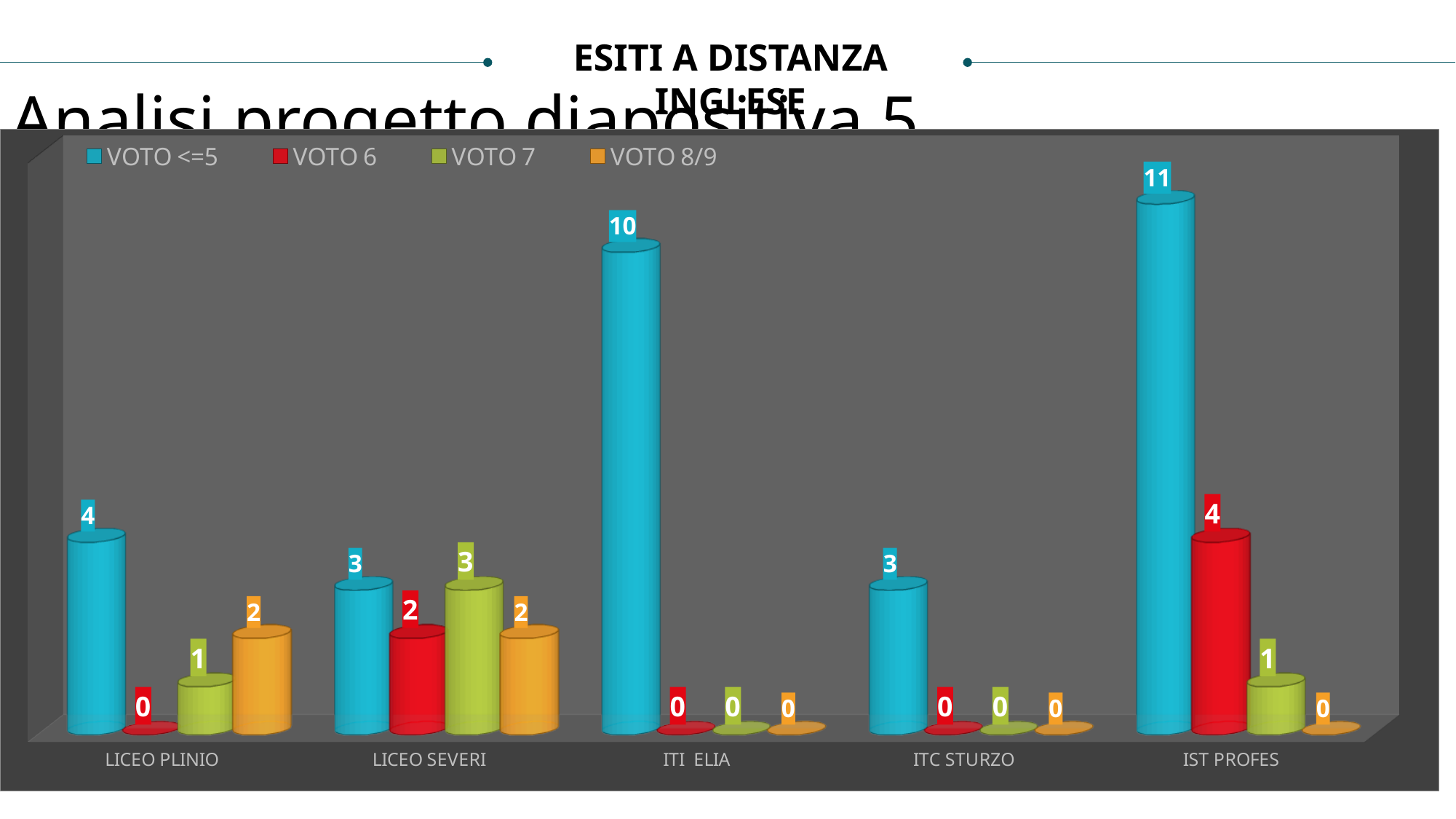
How many schools are shown on the x axis? 5 Which is larger: VOTO 6 at LICEO SEVERI or VOTO 6 at IST PROFES? VOTO 6 at IST PROFES How many series does the legend list? 4 What is the total of all four series for LICEO SEVERI? 10 What is the value for VOTO 8/9 at LICEO PLINIO? 2 What is the value for VOTO <=5 at ITI ELIA? 10 What kind of chart is shown? bar chart What is the value for VOTO 7 at LICEO SEVERI? 3 Which school has the lowest value for VOTO <=5? LICEO SEVERI and ITC STURZO Which school has the highest value for VOTO <=5? IST PROFES What is the difference between the VOTO <=5 values for IST PROFES and ITI ELIA? 1 What is the value for VOTO 6 at IST PROFES? 4